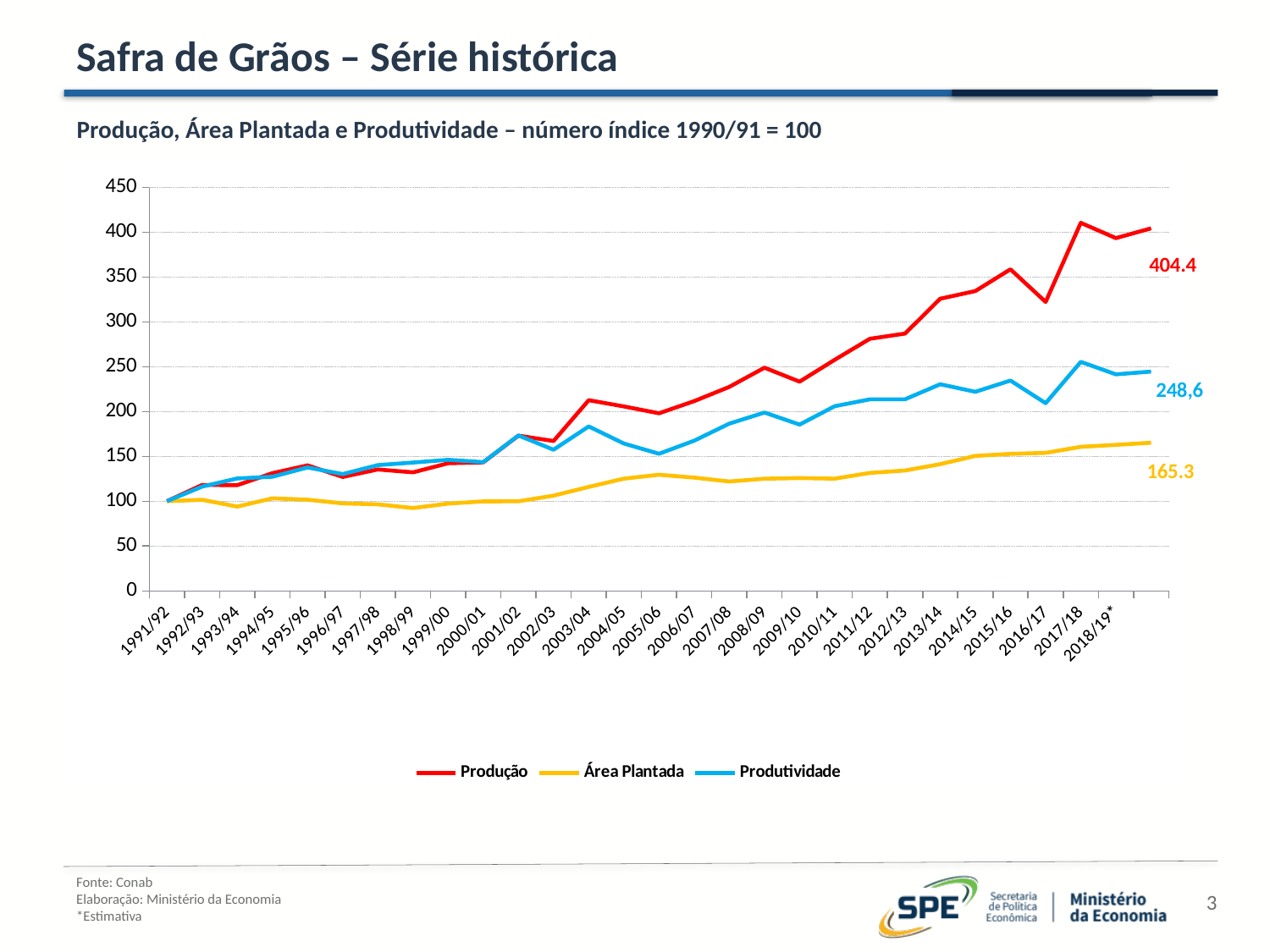
How many series does the legend list? 3 What is the labelled value for Área Plantada at the end of the series (2018/19*)? 165.3 What is the labelled value for Produção at the end of the series (2018/19*)? 404.4 Does the Produção series generally rise or fall from 1991/92 to 2018/19*? Rise Is the value for Produção in 2013/14 greater or less than 300? greater Is the value for Área Plantada in 2005/06 greater or less than 150? less What is the difference between the final labelled values of Produção (404.4) and Área Plantada (165.3)? 239.1 Which series has the lowest value in 2018/19*? Área Plantada What kind of chart is shown on the slide? Line chart In 2018/19*, which is larger: Produção or Produtividade? Produção What is the labelled value for Produtividade at the end of the series (2018/19*)? 248,6 Which series has the highest value in 2018/19*? Produção